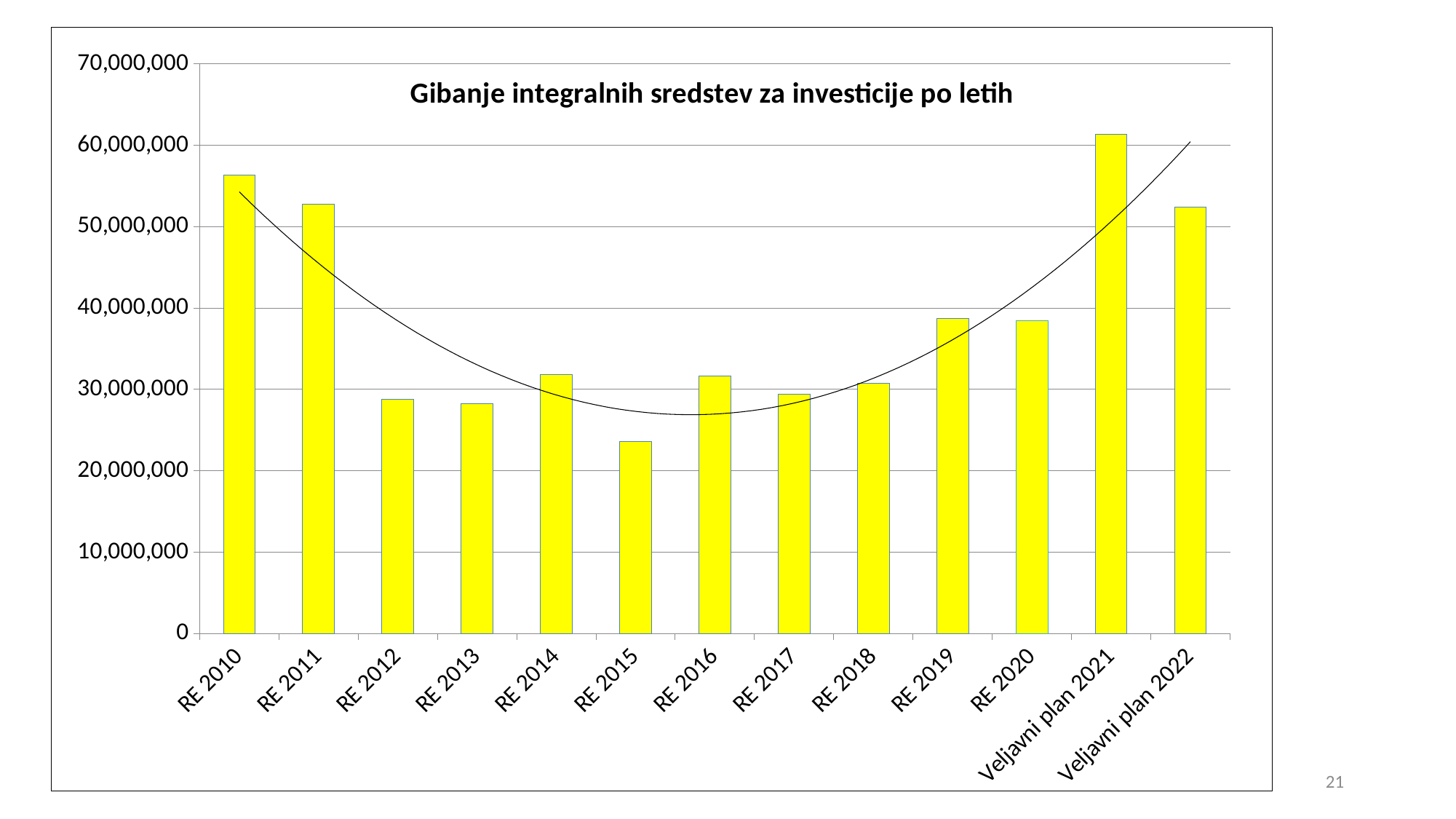
Which category has the lowest value in the chart? RE 2015 What is the title of the chart? Gibanje integralnih sredstev za investicije po letih How many categories are shown on the x axis of the chart? 13 What type of chart is shown on the slide? Bar chart Do the values rise or fall from RE 2010 to RE 2015? fall Is the value for Veljavni plan 2021 greater or less than 60,000,000? greater Is the value for RE 2015 greater or less than 30,000,000? less Which is larger, the value for RE 2010 or the value for RE 2015? RE 2010 Is the value for RE 2019 greater or less than 40,000,000? less Which category has the highest value in the chart? Veljavni plan 2021 Which is larger, the value for RE 2019 or the value for RE 2012? RE 2019